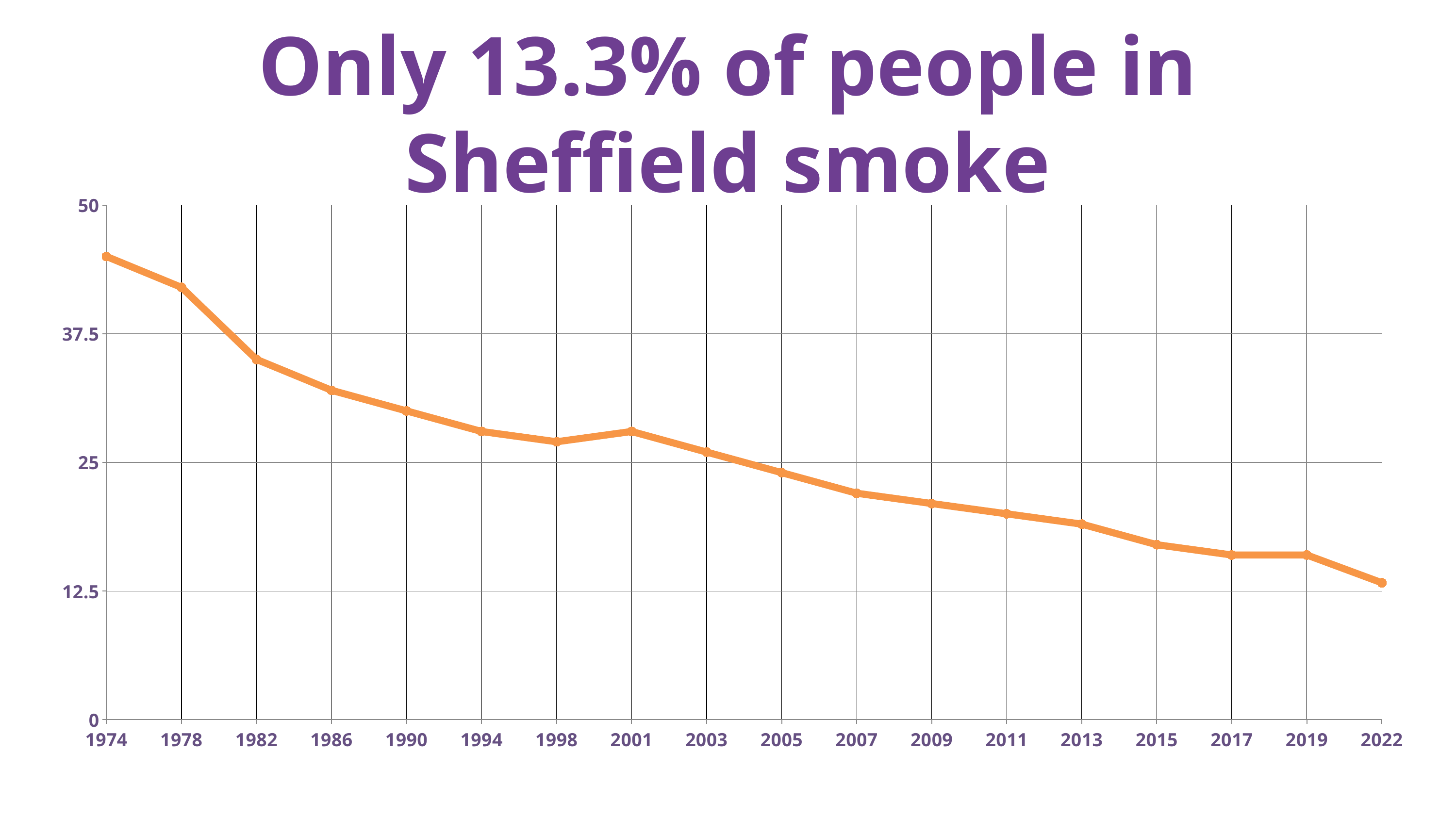
Which year has the lowest value on the chart? 2022 Is the value for 2001 greater or less than 25? greater Which is larger, the value for 1998 or the value for 2001? 2001 How many data points are plotted on the line? 18 Which year has the highest value on the chart? 1974 Is the value for 2015 greater or less than 12.5? greater What percentage of people in Sheffield does the slide title say smoke? 13.3% Is the value for 1982 greater or less than 37.5? less Do the values generally rise or fall from 1974 to 2022? fall What kind of chart is shown on the slide? line chart